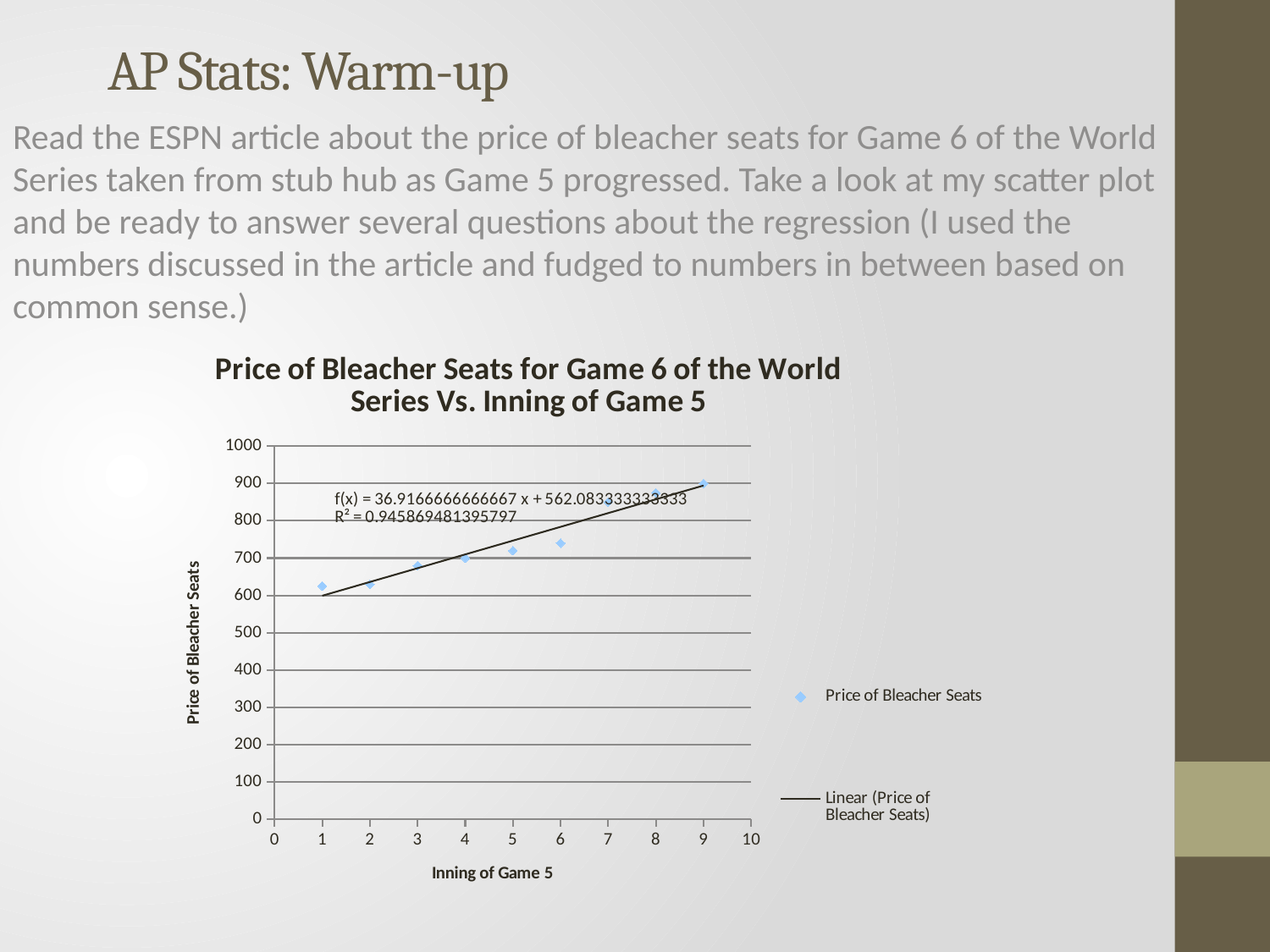
How many entries does the chart's legend list? 2 How many data points are plotted in the chart? 9 Is the price of bleacher seats at inning 7 greater or less than 800? greater What is the R² value printed on the chart? 0.945869481395797 Is the price of bleacher seats at inning 5 greater or less than 800? less What is the label of the x axis of the chart? Inning of Game 5 At which inning is the price of bleacher seats highest? 9 Is the price of bleacher seats at inning 9 greater or less than 800? greater Which has a higher price of bleacher seats, inning 3 or inning 7? inning 7 Do the prices of bleacher seats rise or fall as the inning of Game 5 increases? rise What kind of chart is shown on the slide? scatter plot